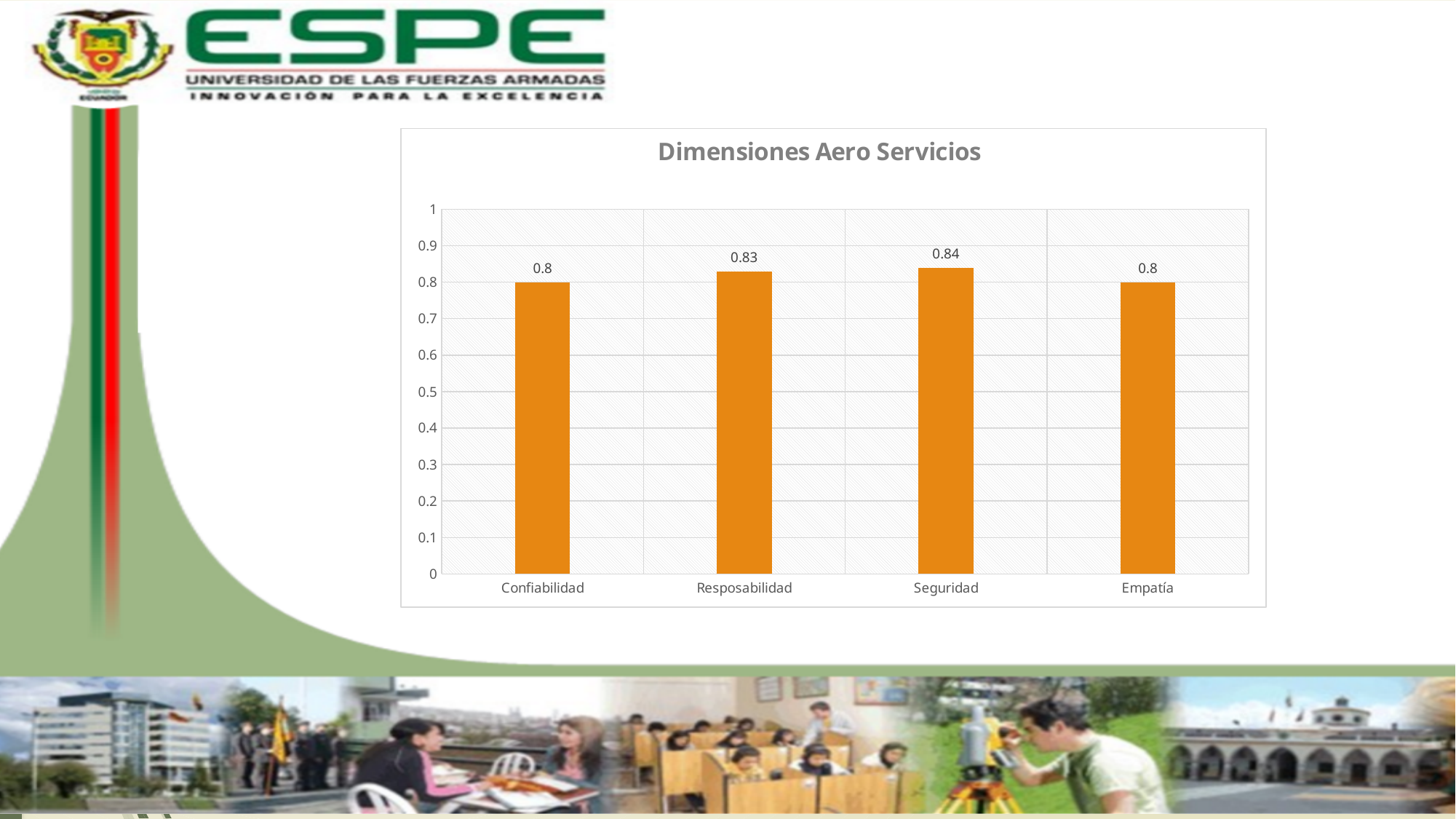
Is the value for Empatía greater or less than 0.9? less Which category has the highest value? Seguridad What is the value for Resposabilidad? 0.83 What kind of chart is shown on the slide? bar chart Is the value for Confiabilidad greater or less than 0.5? greater What is the value for Empatía? 0.8 What is the value for Seguridad? 0.84 What is the difference between the values for Seguridad and Confiabilidad? 0.04 What is the difference between the values for Resposabilidad and Empatía? 0.03 What is the value for Confiabilidad? 0.8 Which is larger, the value for Seguridad or the value for Empatía? Seguridad How many categories are shown on the x axis? 4